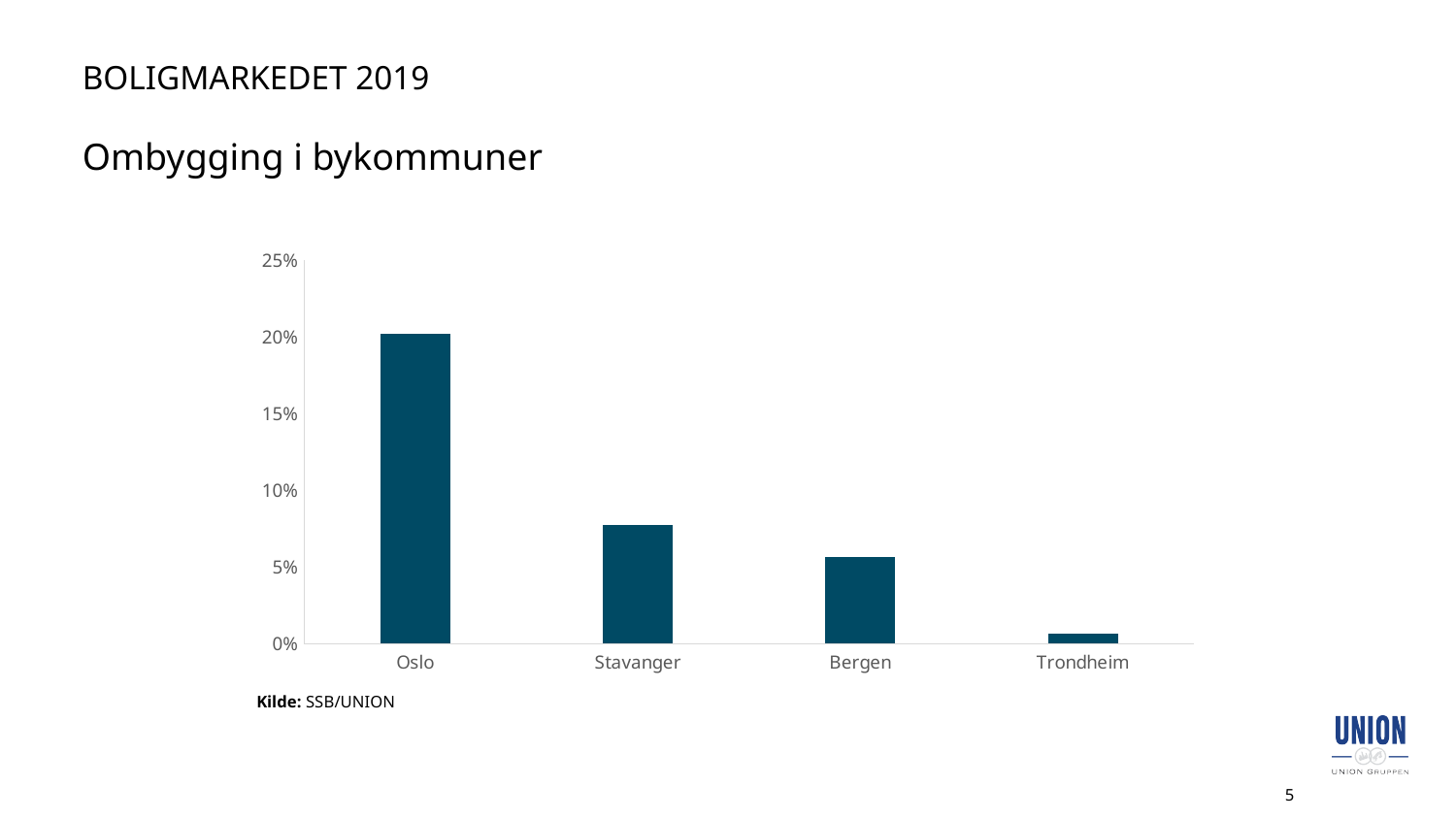
Do the values rise or fall from left to right along the x axis? fall Which has a larger value, Bergen or Trondheim? Bergen Which city has the highest value in the chart? Oslo How many cities are shown on the x axis of the chart? 4 Which city has the lowest value in the chart? Trondheim Is the value for Bergen greater or less than 5%? greater Is the value for Trondheim greater or less than 5%? less Is the value for Stavanger greater or less than 10%? less Which has a larger value, Stavanger or Bergen? Stavanger What kind of chart is shown on the slide? bar chart What is the title of the chart on the slide? Ombygging i bykommuner